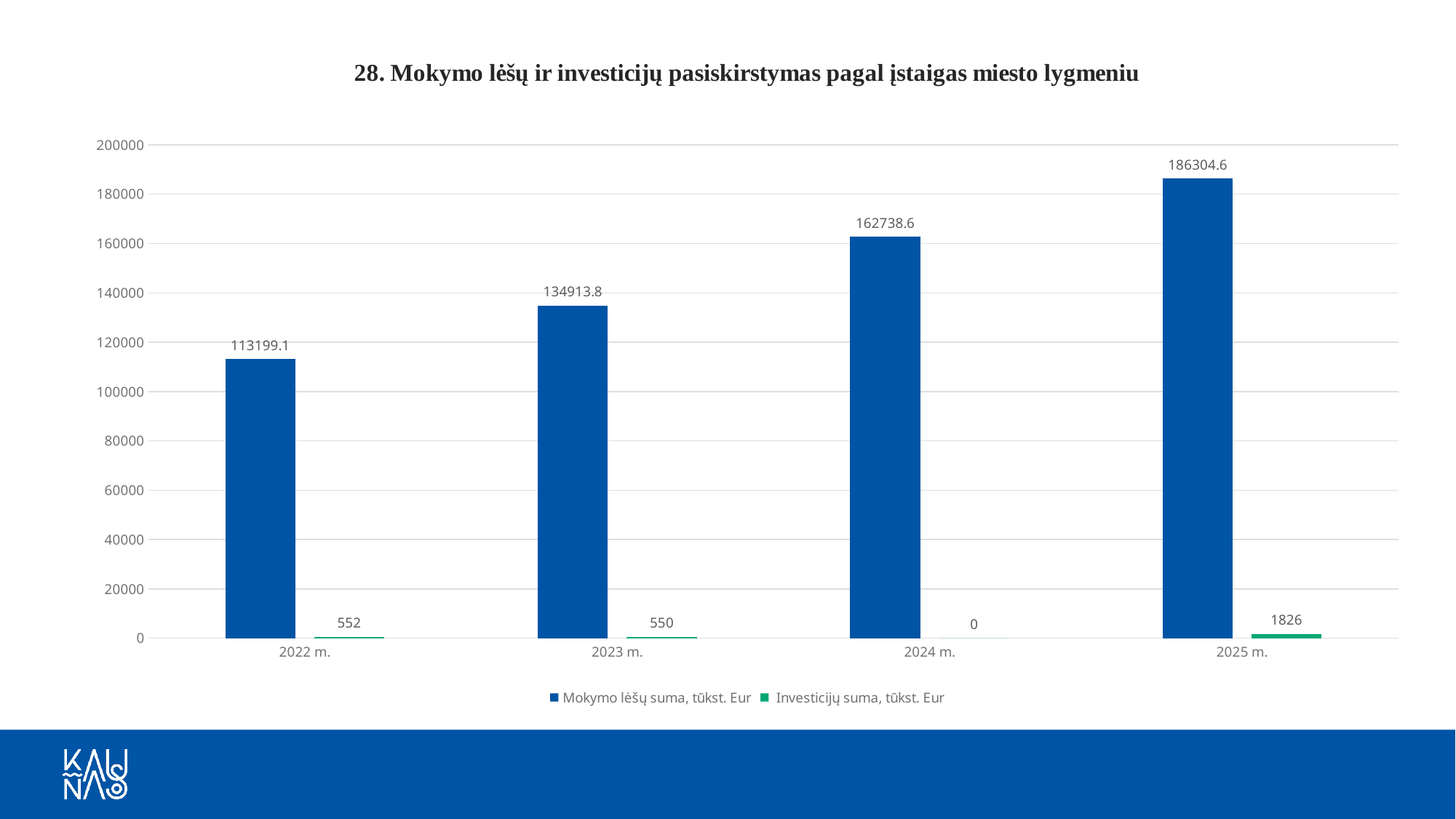
What is the value of 'Mokymo lėšų suma, tūkst. Eur' for 2024 m.? 162738.6 Does 'Mokymo lėšų suma, tūkst. Eur' rise or fall from 2022 m. to 2025 m.? rise Is the value of 'Mokymo lėšų suma, tūkst. Eur' for 2023 m. greater or less than 140000? less Which year has the highest value for 'Mokymo lėšų suma, tūkst. Eur'? 2025 m. Which is larger: 'Investicijų suma, tūkst. Eur' for 2022 m. or for 2023 m.? 2022 m. What is the value of 'Investicijų suma, tūkst. Eur' for 2025 m.? 1826 What is the value of 'Mokymo lėšų suma, tūkst. Eur' for 2022 m.? 113199.1 How many years are shown on the x axis? 4 Which year has the lowest value for 'Investicijų suma, tūkst. Eur'? 2024 m. What is the value of 'Investicijų suma, tūkst. Eur' for 2024 m.? 0 How many series does the legend list? 2 What is the difference between the 'Mokymo lėšų suma, tūkst. Eur' values for 2025 m. and 2024 m.? 23566